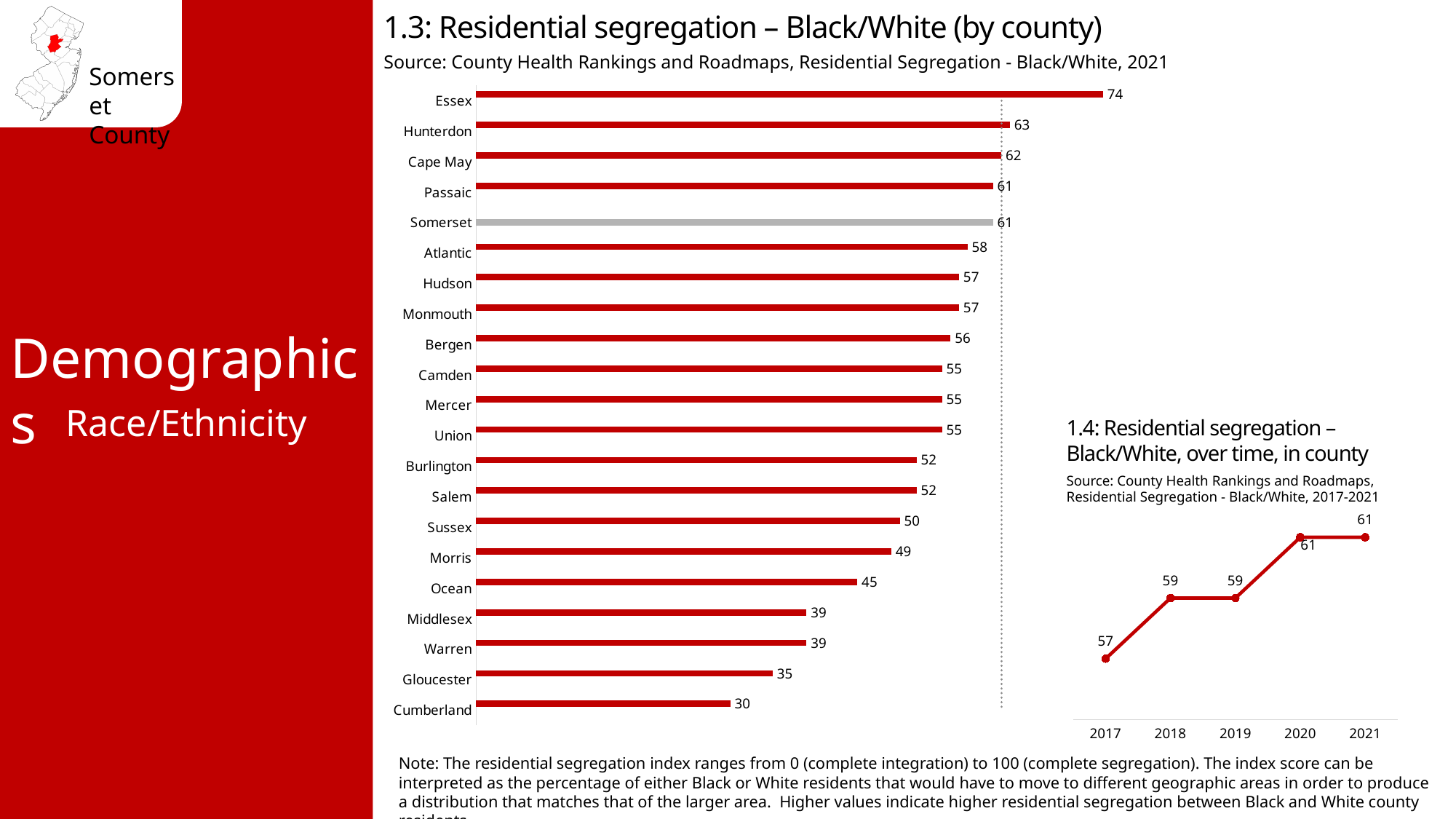
In chart 1.3 (Residential segregation – Black/White by county), what is the value for Essex? 74 In chart 1.4 (Residential segregation – Black/White over time in county), what is the value for 2017? 57 In chart 1.3 (Residential segregation – Black/White by county), what is the value for Somerset? 61 In chart 1.3 (Residential segregation – Black/White by county), which has a larger value, Morris or Ocean? Morris In chart 1.3 (Residential segregation – Black/White by county), what is the difference between the values for Essex and Cumberland? 44 In chart 1.4 (Residential segregation – Black/White over time in county), how many years are plotted? 5 In chart 1.3 (Residential segregation – Black/White by county), how many counties are shown? 21 What kind of chart is chart 1.3 (Residential segregation – Black/White by county)? Bar chart In chart 1.3 (Residential segregation – Black/White by county), which county has the lowest value? Cumberland In chart 1.3 (Residential segregation – Black/White by county), which county has the highest value? Essex In chart 1.4 (Residential segregation – Black/White over time in county), what is the difference between the 2021 and 2017 values? 4 In chart 1.4 (Residential segregation – Black/White over time in county), do the values rise or fall from 2017 to 2021? Rise